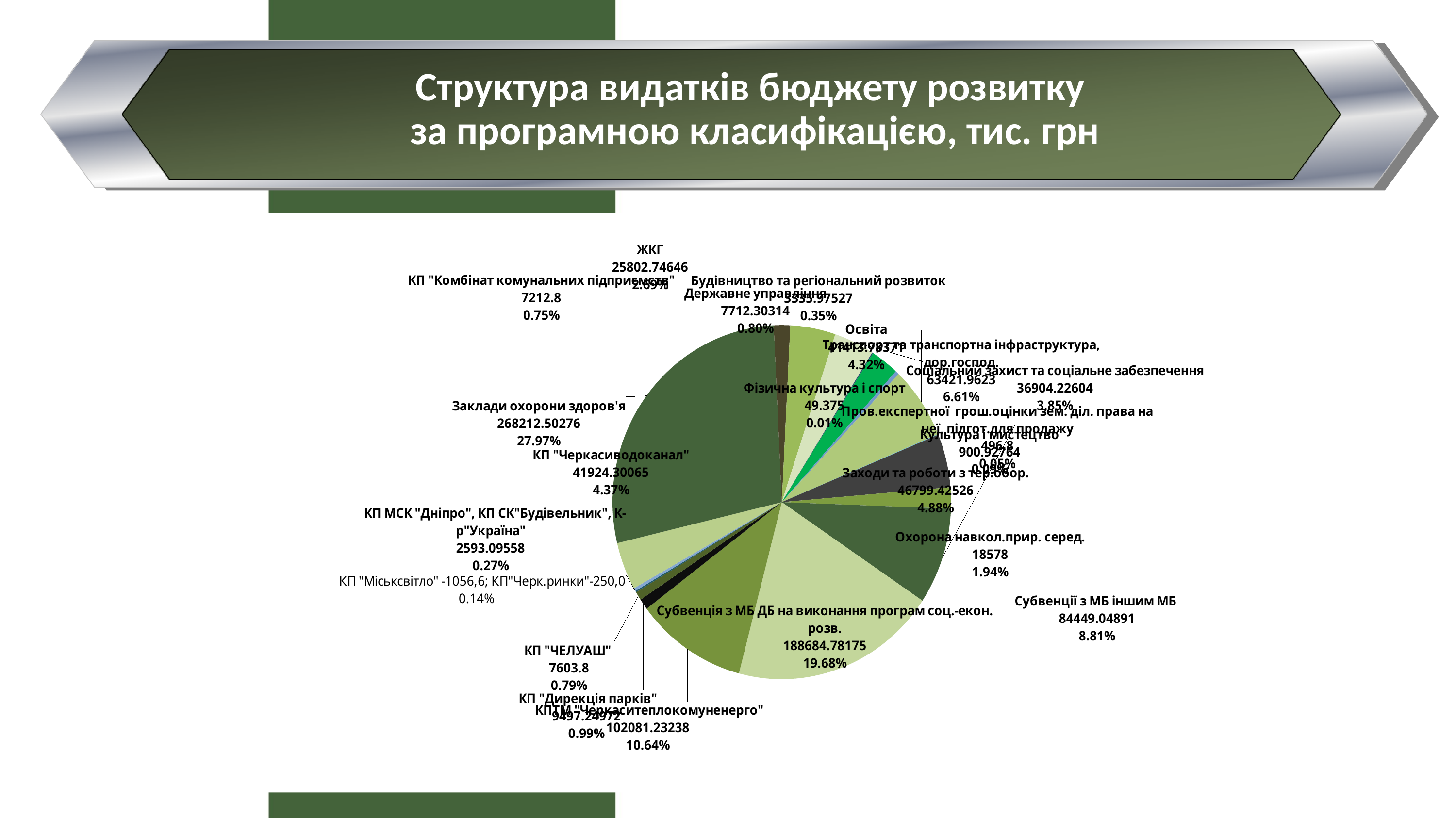
Which is larger: the value for Заходи та роботи з тер.обор. or the value for КП "Черкасиводоканал"? Заходи та роботи з тер.обор. What is the value for Заклади охорони здоров'я? 268212.50276 What kind of chart is shown on the slide? pie chart What is the value for Субвенції з МБ іншим МБ? 84449.04891 What share of the pie does Транспорт та транспортна інфраструктура, дор.госп. represent? 6.61% What share of the pie does КПТМ "Черкаситеплокомуненерго" represent? 10.64% Which category has the largest share of the pie? Заклади охорони здоров'я What is the value for Охорона навкол.прир. серед.? 18578 What is the title of the slide? Структура видатків бюджету розвитку за програмною класифікацією, тис. грн What is the difference between the share of Субвенція з МБ ДБ на виконання програм соц.-екон. розв. and the share of Субвенції з МБ іншим МБ? 10.87% What share of the pie does Заклади охорони здоров'я represent? 27.97% Which category has the smallest share of the pie? Фізична культура і спорт